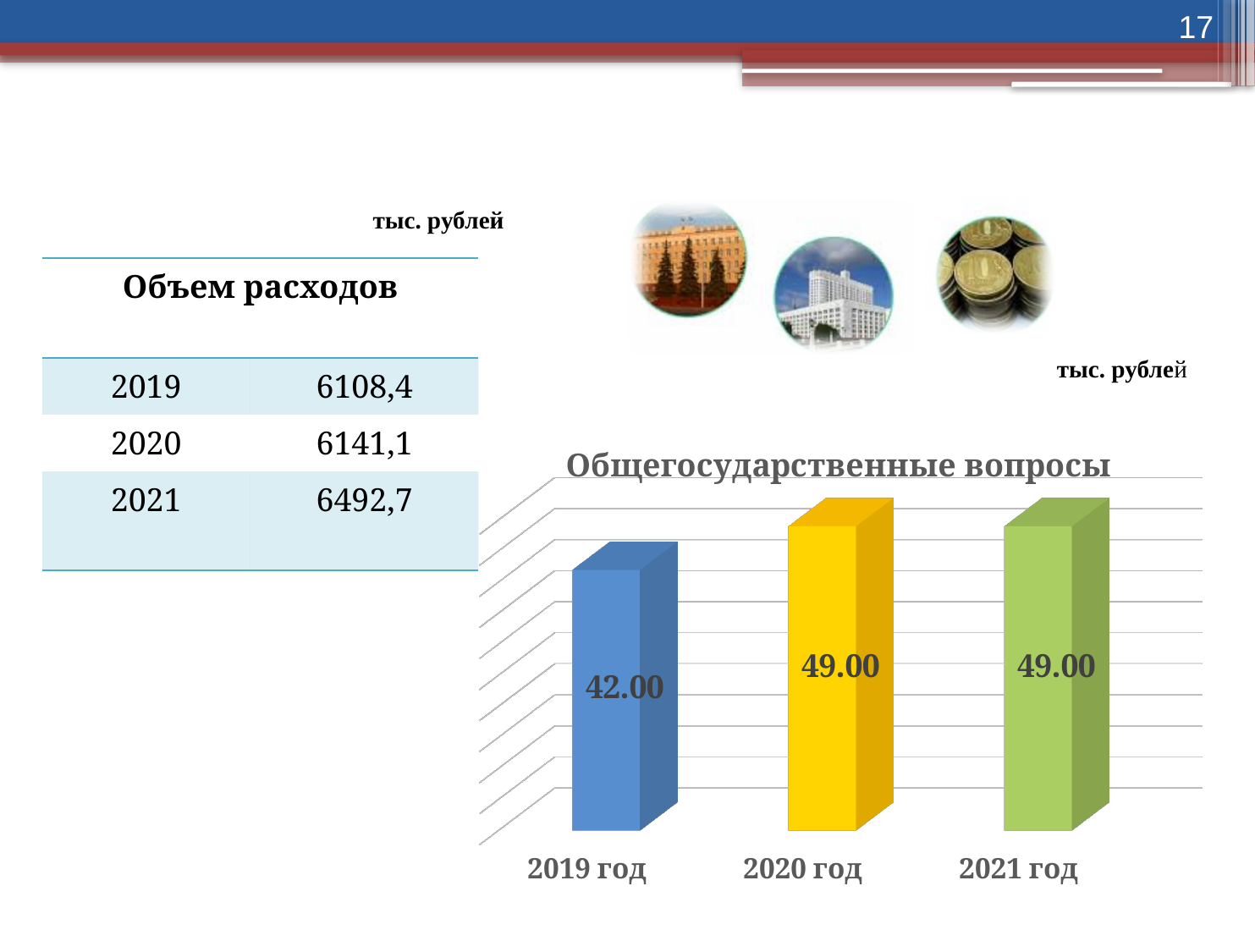
What is the title of the chart? Общегосударственные вопросы What is the value for 2020 год in the chart? 49.00 Which is larger, the value for 2019 год or the value for 2021 год? 2021 год Which year has the lowest value in the chart? 2019 год Does the value rise or fall from 2019 год to 2020 год? Rise What is the value for 2019 год in the chart? 42.00 What is the difference between the values for 2020 год and 2019 год? 7.00 What colour is the bar for 2020 год? Yellow What is the value for 2021 год in the chart? 49.00 How many years are shown in the chart? 3 Are the values for 2020 год and 2021 год equal? Yes What kind of chart is shown on the slide? Bar chart